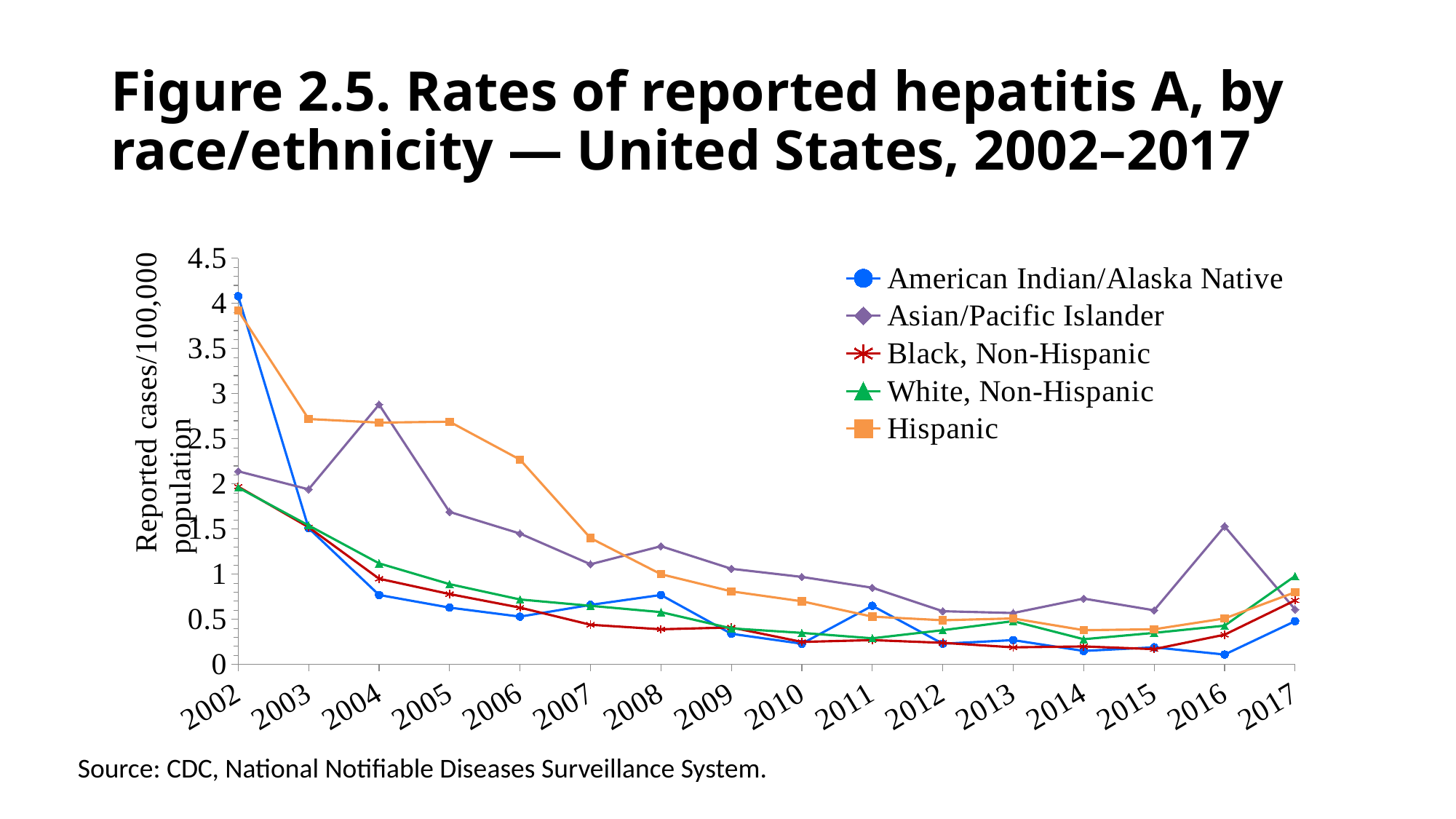
What is the label on the y axis? Reported cases/100,000 population In 2016, which race/ethnicity group has the highest rate? Asian/Pacific Islander In 2005, which is higher, the Hispanic rate or the Asian/Pacific Islander rate? Hispanic What kind of chart is shown on the slide? Line chart How many years are plotted along the x axis? 16 Is the American Indian/Alaska Native value in 2002 greater or less than 3.5? greater Is the Hispanic value in 2003 greater or less than 2.5? greater In 2017, which is higher, the White, Non-Hispanic rate or the Black, Non-Hispanic rate? White, Non-Hispanic In 2008, which race/ethnicity group has the highest rate? Asian/Pacific Islander How many series does the legend list? 5 In 2016, which race/ethnicity group has the lowest rate? American Indian/Alaska Native Does the Hispanic line generally rise or fall from 2002 to 2017? fall